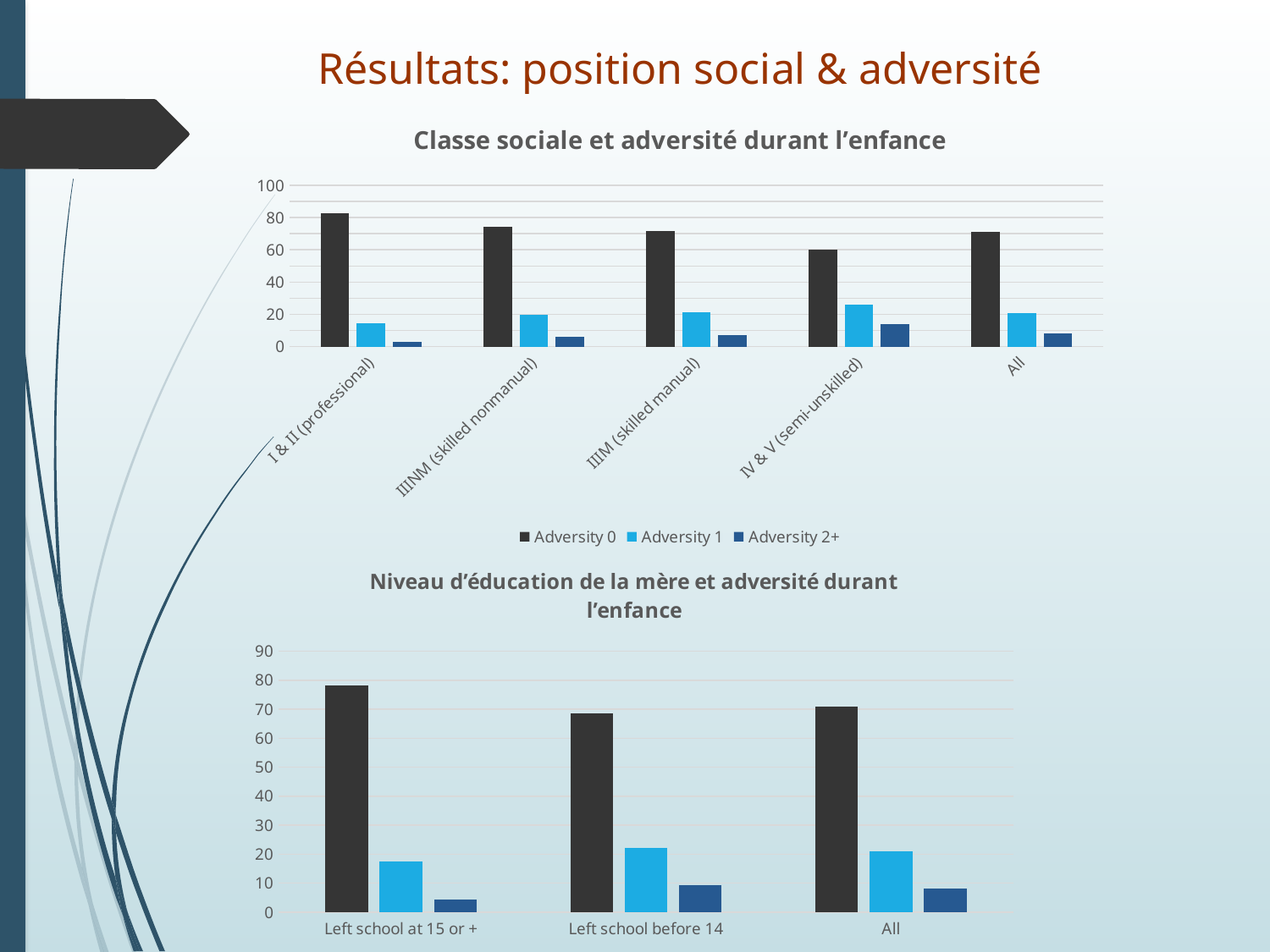
In the top chart 'Classe sociale et adversité durant l'enfance', is the Adversity 1 value for IV & V (semi-unskilled) greater or less than 20? greater In the top chart 'Classe sociale et adversité durant l'enfance', is the Adversity 0 value for I & II (professional) greater or less than 80? greater In the top chart 'Classe sociale et adversité durant l'enfance', which social class has the highest Adversity 0 bar? I & II (professional) In the bottom chart 'Niveau d'éducation de la mère et adversité durant l'enfance', is the Adversity 1 value for 'Left school before 14' greater or less than 20? greater What kind of chart is the top chart 'Classe sociale et adversité durant l'enfance'? bar chart In the top chart 'Classe sociale et adversité durant l'enfance', how many series does the legend list? 3 In the bottom chart 'Niveau d'éducation de la mère et adversité durant l'enfance', how many categories are shown on the x axis? 3 In the top chart 'Classe sociale et adversité durant l'enfance', how many social class categories are shown on the x axis? 5 In the top chart 'Classe sociale et adversité durant l'enfance', which social class has the highest Adversity 2+ bar? IV & V (semi-unskilled) In the top chart 'Classe sociale et adversité durant l'enfance', which social class has the lowest Adversity 0 bar? IV & V (semi-unskilled) In the bottom chart 'Niveau d'éducation de la mère et adversité durant l'enfance', which has the higher Adversity 0 value: 'Left school at 15 or +' or 'Left school before 14'? Left school at 15 or +